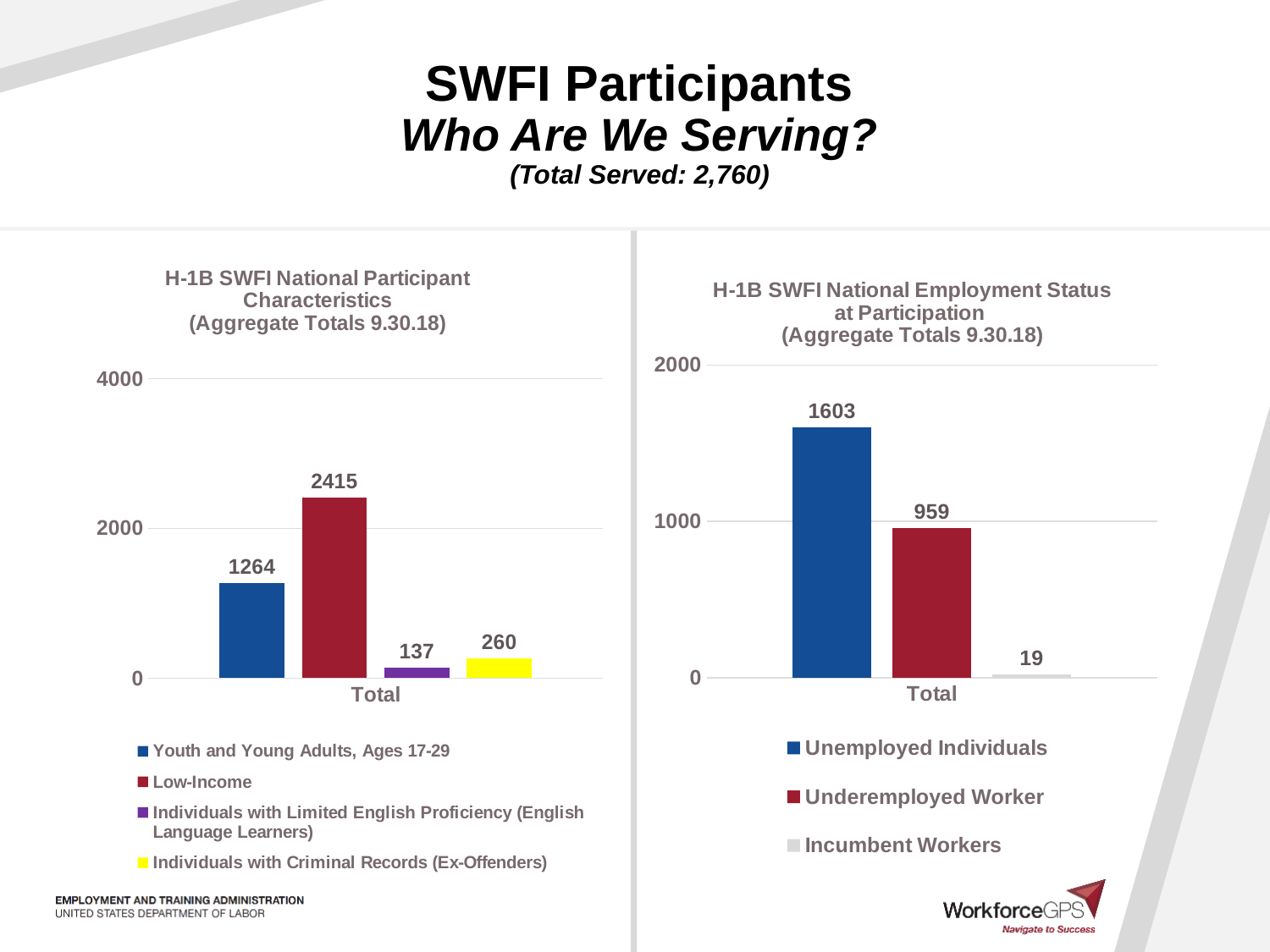
In the H-1B SWFI National Employment Status at Participation chart, what colour is the Incumbent Workers series? Light grey In the H-1B SWFI National Participant Characteristics chart, which series has the lowest value? Individuals with Limited English Proficiency (English Language Learners) In the H-1B SWFI National Participant Characteristics chart, how many series does the legend list? 4 In the H-1B SWFI National Employment Status at Participation chart, what is the value for Underemployed Worker? 959 In the H-1B SWFI National Employment Status at Participation chart, which is larger: Incumbent Workers or Underemployed Worker? Underemployed Worker What kind of chart is the H-1B SWFI National Employment Status at Participation chart? Bar chart In the H-1B SWFI National Participant Characteristics chart, what is the value for Youth and Young Adults, Ages 17-29? 1264 In the H-1B SWFI National Participant Characteristics chart, is the value for Individuals with Criminal Records (Ex-Offenders) greater or less than 2000? less In the H-1B SWFI National Employment Status at Participation chart, which series has the highest value? Unemployed Individuals In the H-1B SWFI National Participant Characteristics chart, what is the difference between Low-Income and Youth and Young Adults, Ages 17-29? 1151 In the H-1B SWFI National Employment Status at Participation chart, what is the difference between Unemployed Individuals and Underemployed Worker? 644 In the H-1B SWFI National Participant Characteristics chart, what is the value for Low-Income? 2415